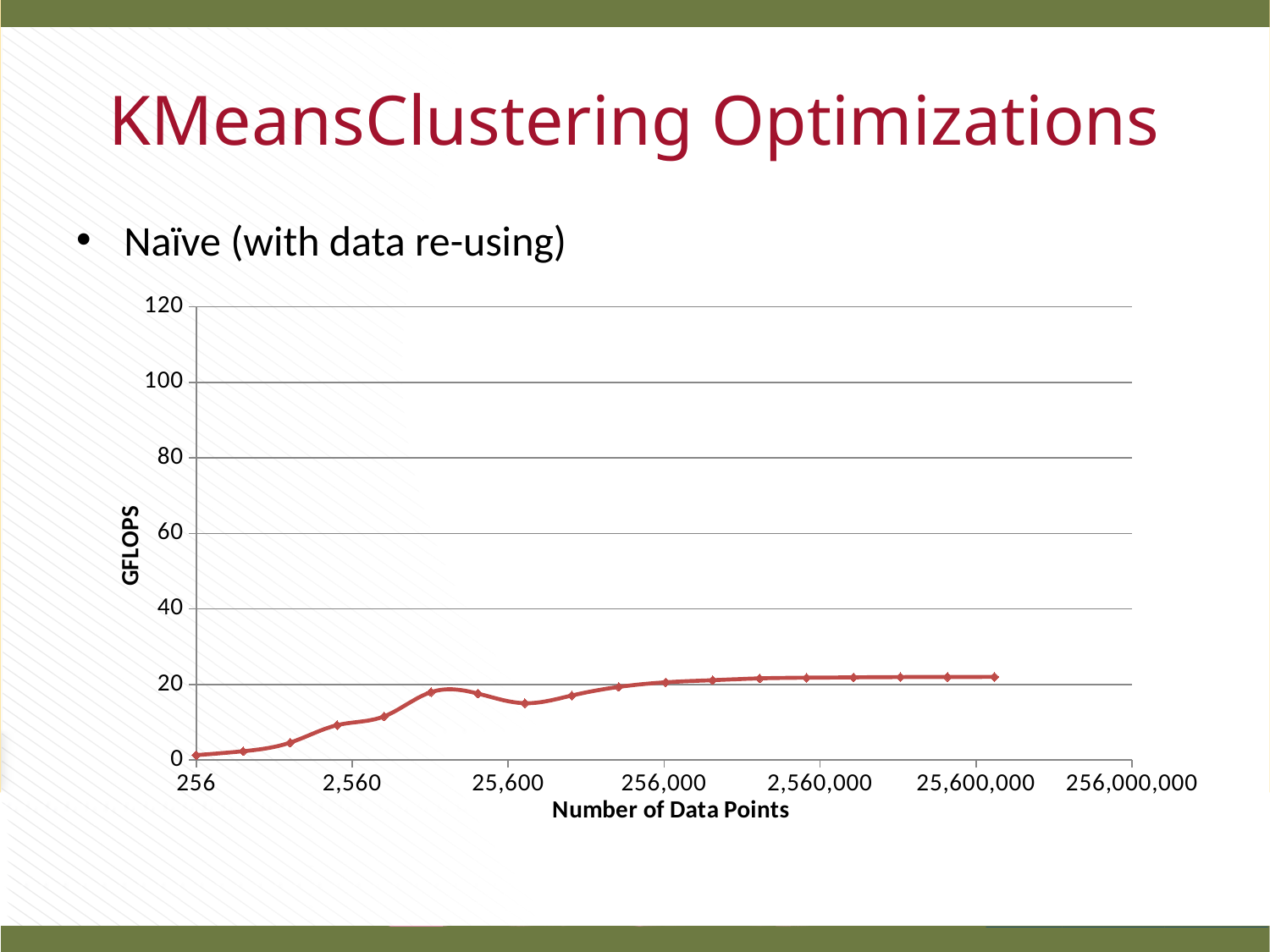
What is the label of the y axis of the chart? GFLOPS What kind of chart is shown on the slide? line chart Is the GFLOPS value at 256,000 data points greater or less than 10? greater What is the label of the x axis of the chart? Number of Data Points Is the GFLOPS value at 2,560 data points greater or less than 20? less What is the highest value shown on the y axis of the chart? 120 Is the GFLOPS value at 25,600 data points greater or less than 10? greater Which has the higher GFLOPS value: 2,560 data points or 256,000 data points? 256,000 Do the GFLOPS values generally rise or fall as the number of data points increases? rise At which number of data points is the GFLOPS value lowest? 256